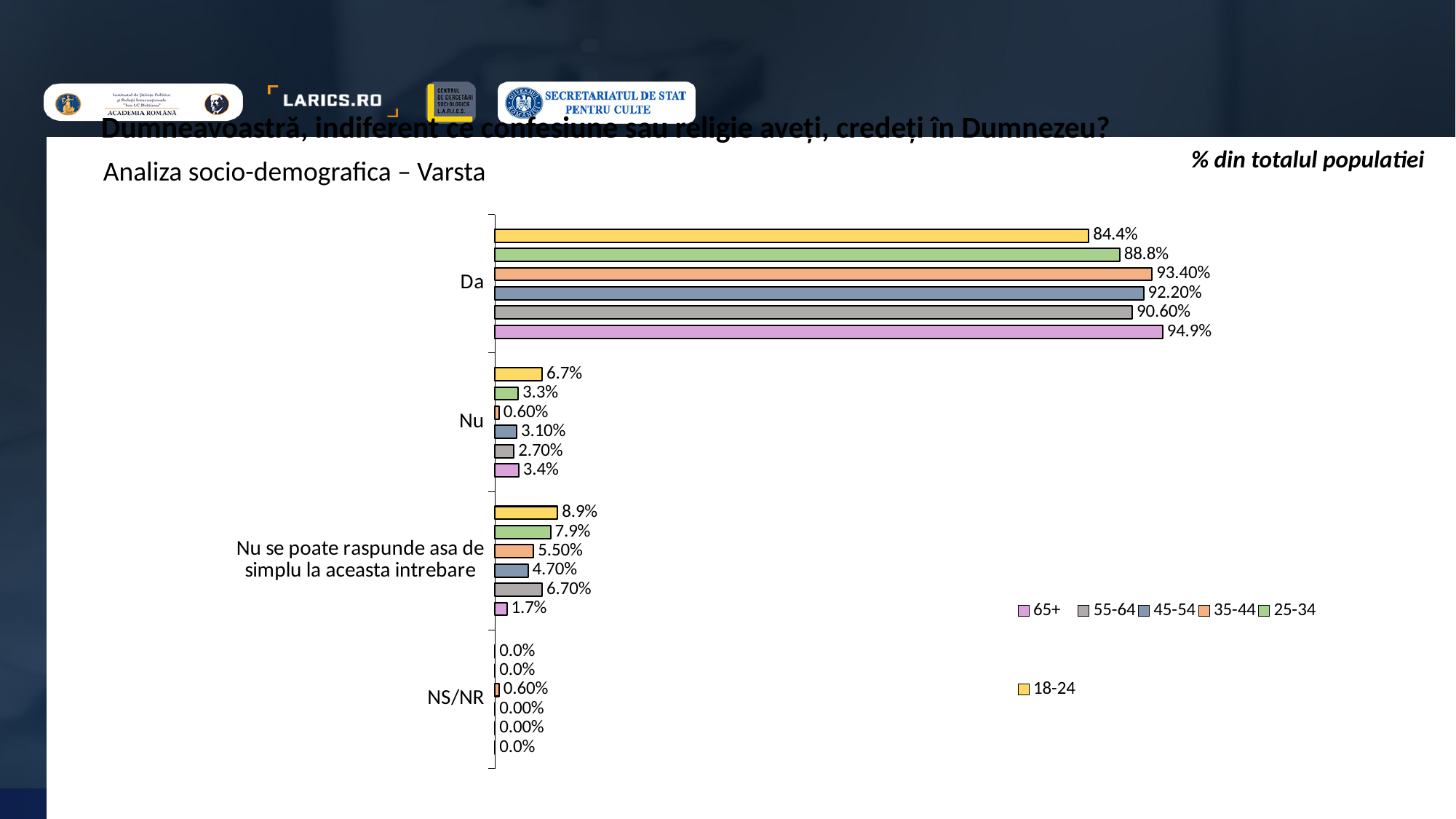
For 'Nu', which is larger: the value for 18-24 or the value for 25-34? 18-24 What is the value for the 65+ age group for 'Da'? 94.9% Which age group has the highest value for 'Da'? 65+ What is the value for the 55-64 age group for 'Nu se poate raspunde asa de simplu la aceasta intrebare'? 6.70% Which age group has the lowest value for 'Nu se poate raspunde asa de simplu la aceasta intrebare'? 65+ What kind of chart is shown on the slide? bar chart Which age group has a non-zero value for 'NS/NR'? 35-44 What is the value for the 35-44 age group for 'Nu'? 0.60% What is the value for the 18-24 age group for 'Da'? 84.4% What is the difference between the 65+ and 18-24 values for 'Da'? 10.5% How many response categories are shown on the vertical axis? 4 How many series does the legend list? 6